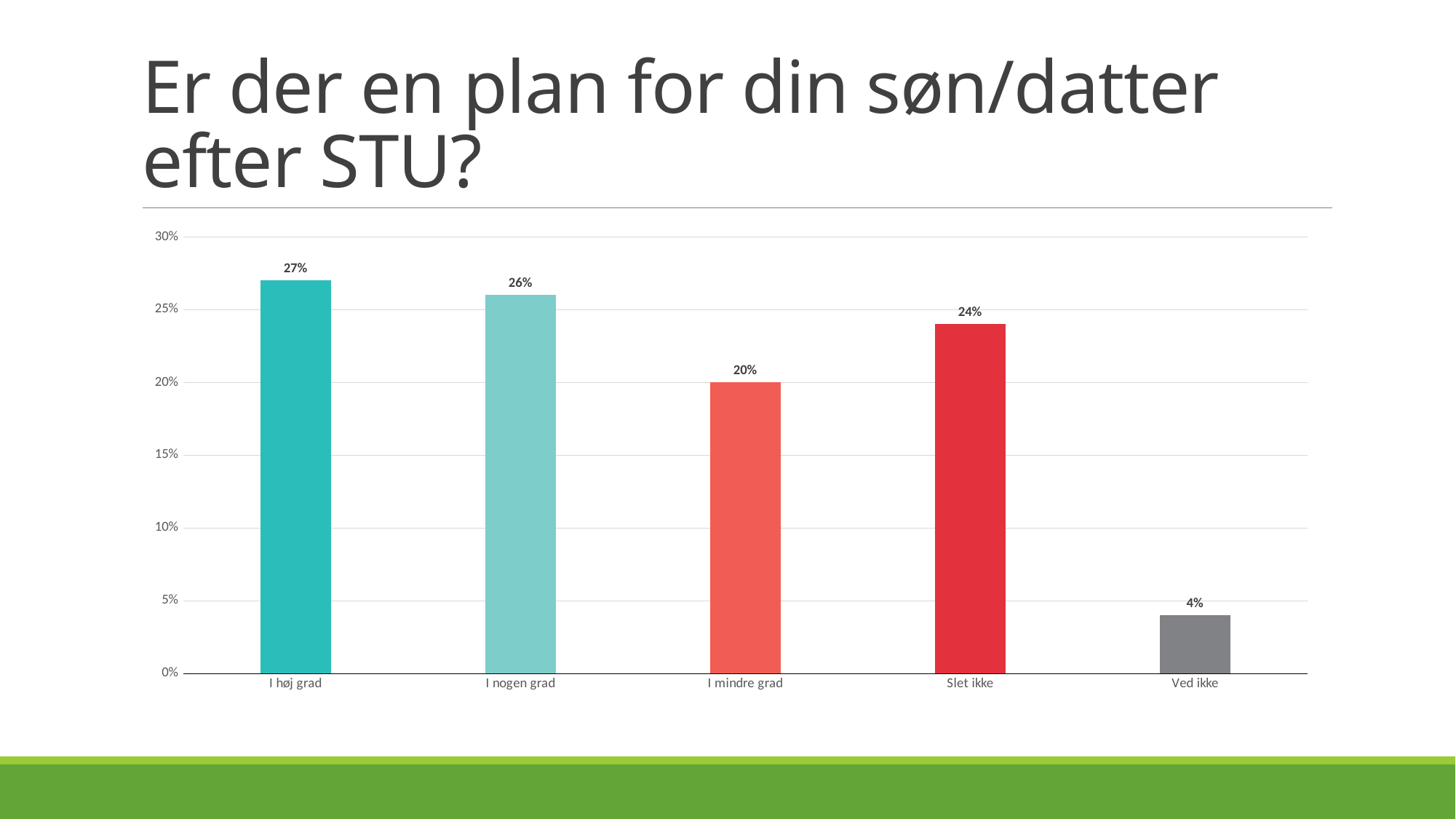
Which category has the lowest value? Ved ikke What is the title of the slide? Er der en plan for din søn/datter efter STU? What is the difference between the values for "Slet ikke" and "Ved ikke"? 20% How many categories are shown on the x axis? 5 Which is larger, the value for "I nogen grad" or the value for "Slet ikke"? I nogen grad What kind of chart is shown on the slide? bar chart What is the value for "Slet ikke"? 24% What is the value for "I høj grad"? 27% Which category has the highest value? I høj grad Is the value for "I mindre grad" greater or less than 25%? less What is the difference between the values for "I høj grad" and "I mindre grad"? 7% What is the value for "Ved ikke"? 4%